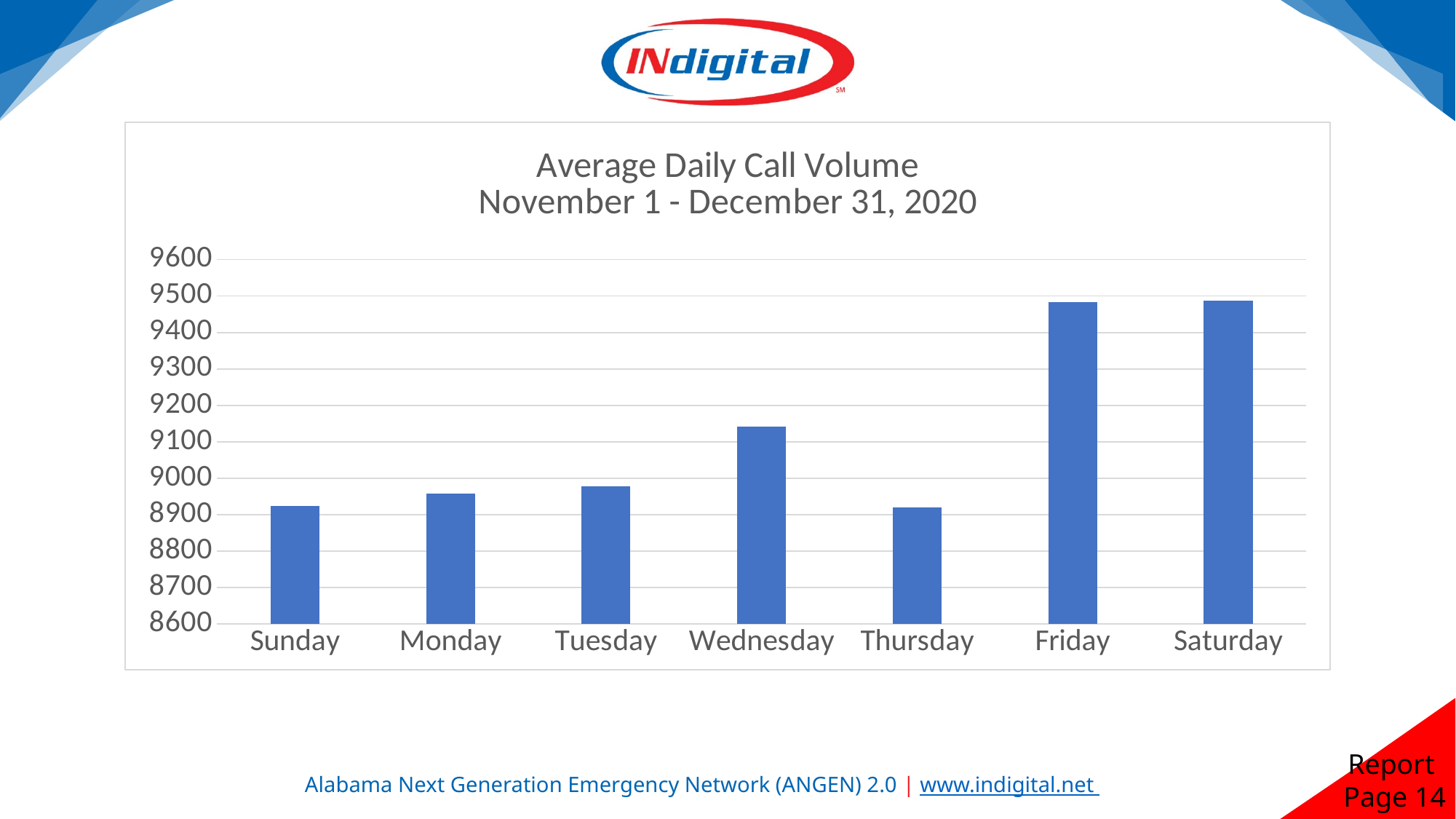
Which has the higher average daily call volume, Wednesday or Thursday? Wednesday Which has the higher average daily call volume, Friday or Sunday? Friday What is the title of the chart? Average Daily Call Volume November 1 - December 31, 2020 Is the value for Sunday greater or less than 9000? less How many days of the week are plotted on the chart? 7 Is the value for Wednesday greater or less than 9100? greater Which has the higher average daily call volume, Monday or Wednesday? Wednesday Is the value for Friday greater or less than 9400? greater What kind of chart is shown on the slide? bar chart